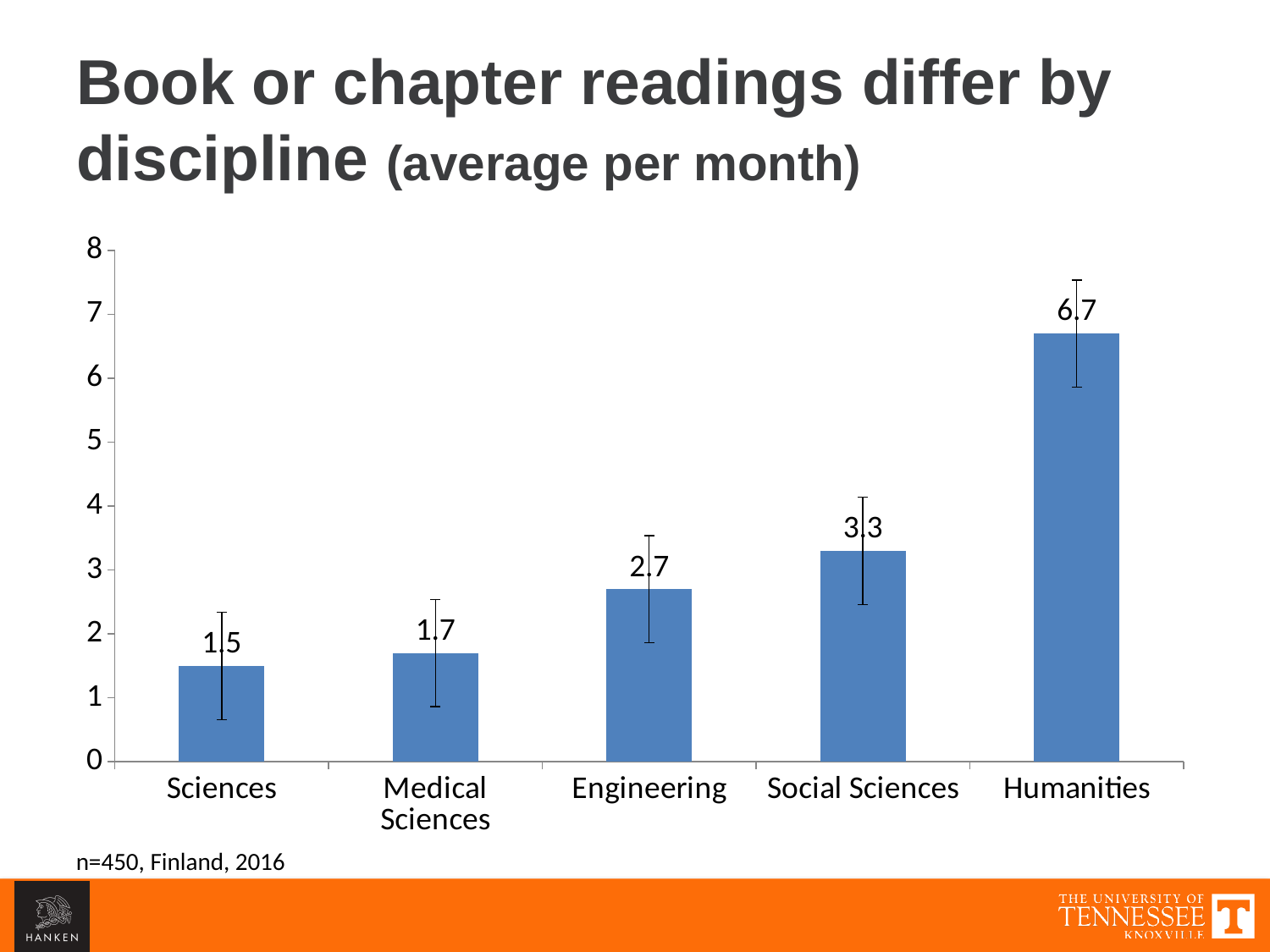
What is the difference between the values for Humanities and Social Sciences? 3.4 Is the value for Humanities greater or less than 6? greater Which is larger, the value for Social Sciences or the value for Engineering? Social Sciences How many disciplines are shown on the x axis? 5 What is the value shown for Medical Sciences? 1.7 Which discipline has the highest average book or chapter readings per month? Humanities Do the values rise or fall moving from Sciences to Humanities along the x axis? Rise What is the difference between the values for Engineering and Sciences? 1.2 What kind of chart is shown on the slide? Bar chart Which discipline has the lowest average book or chapter readings per month? Sciences What is the value shown for Engineering? 2.7 What is the average number of book or chapter readings per month for Humanities? 6.7